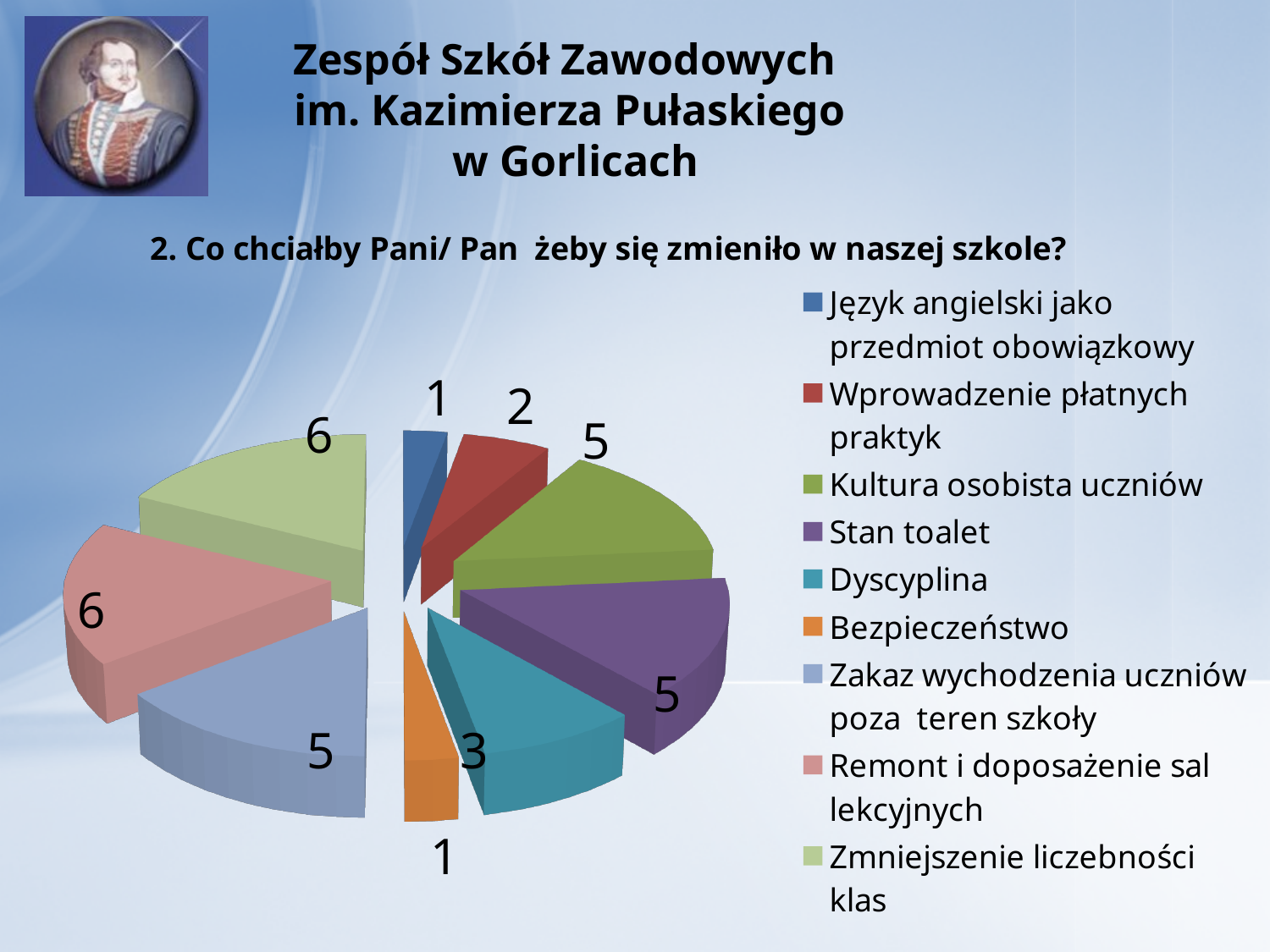
What is the value for "Remont i doposażenie sal lekcyjnych"? 6 What is the value for "Bezpieczeństwo"? 1 What is the difference between the value for "Kultura osobista uczniów" and the value for "Wprowadzenie płatnych praktyk"? 3 What is the value for "Stan toalet"? 5 What is the value for "Dyscyplina"? 3 What is the value for "Wprowadzenie płatnych praktyk"? 2 How many categories does the pie chart have? 9 What is the difference between the value for "Remont i doposażenie sal lekcyjnych" and the value for "Dyscyplina"? 3 What kind of chart is shown on the slide? Pie chart Which is larger, the value for "Zmniejszenie liczebności klas" or the value for "Dyscyplina"? Zmniejszenie liczebności klas What question is the pie chart answering, according to the text above it? 2. Co chciałby Pani/ Pan żeby się zmieniło w naszej szkole? What is the total of all the values in the pie chart? 34